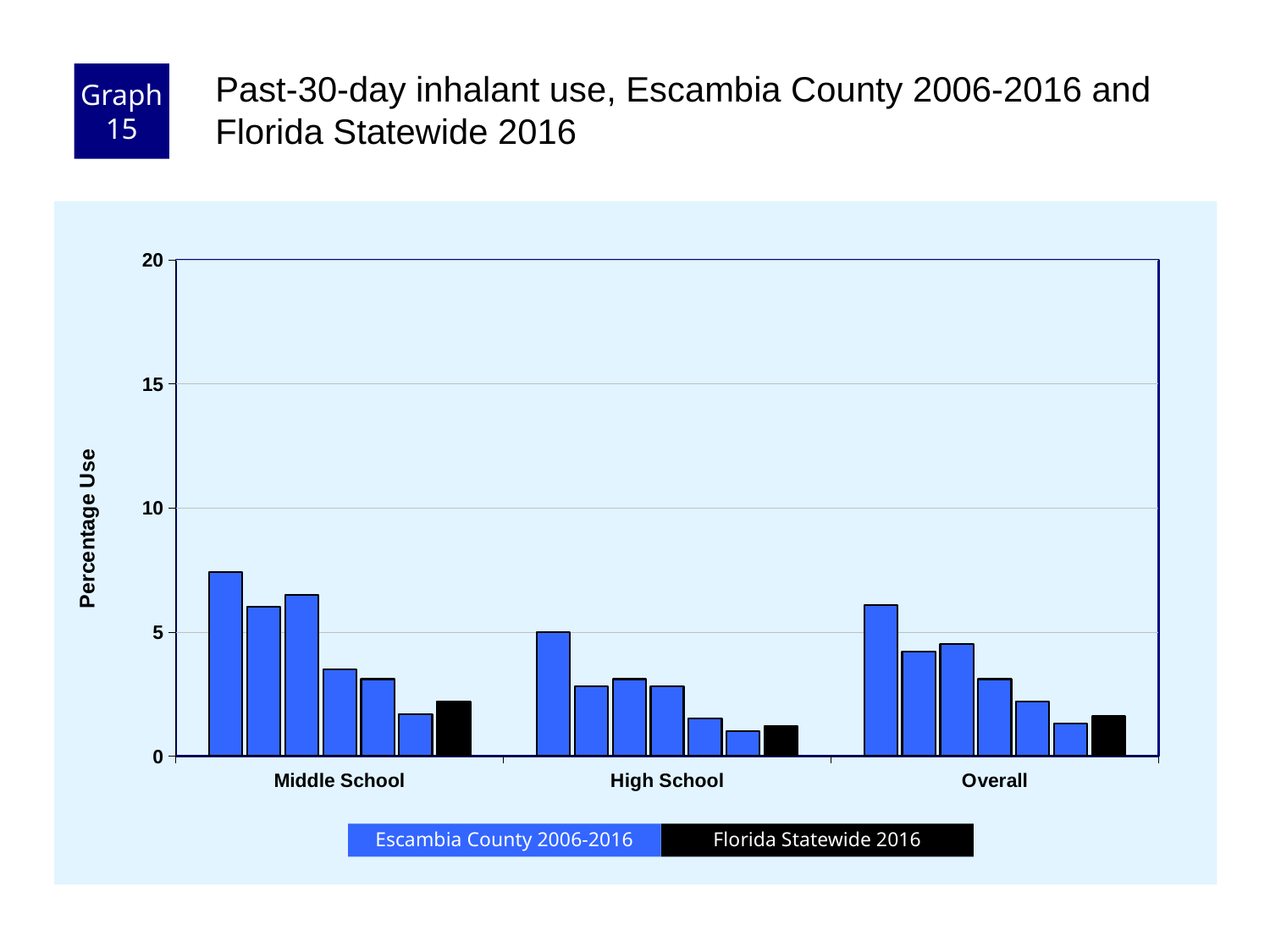
Is the Florida Statewide 2016 bar larger for Middle School or for Overall? Middle School How many categories are shown on the x axis? 3 Which series is shown in black in the legend? Florida Statewide 2016 Is the tallest Middle School bar greater or less than 5? greater Is the tallest Overall bar greater or less than 10? less Is the Florida Statewide 2016 value for High School greater or less than 5? less Which category contains the tallest bar on the chart? Middle School What kind of chart is shown on the slide? bar chart Do the Escambia County bars within the High School group generally rise or fall from left to right? fall Is the Florida Statewide 2016 bar larger for Middle School or for High School? Middle School What is the label of the y axis? Percentage Use How many series does the legend list? 2